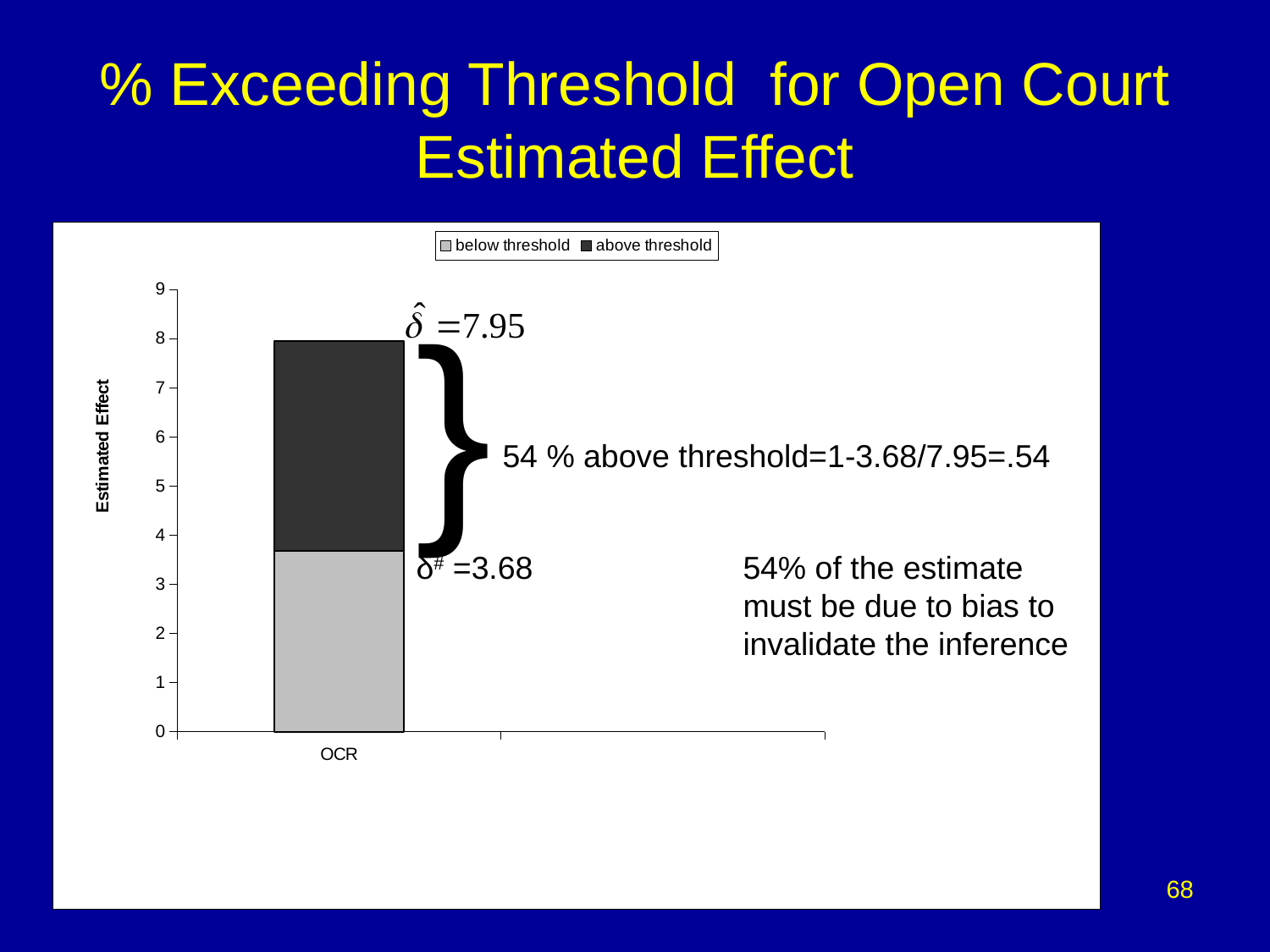
What is the label of the single category on the x axis? OCR What is the difference between the total bar height (7.95) and the below-threshold value (3.68), i.e. the size of the 'above threshold' portion? 4.27 What percentage of the OCR estimate is above the threshold, according to the annotation on the chart? 54% Which portion of the OCR bar is larger, 'above threshold' or 'below threshold'? above threshold What is the total height of the stacked OCR bar? 7.95 What kind of chart is shown on the slide? Stacked bar chart What is the value of the 'below threshold' portion of the OCR bar? 3.68 What is the title of the chart's y axis? Estimated Effect How many categories are plotted on the x axis of the chart? 1 How many series does the chart's legend list? 2 What are the two series named in the chart's legend? below threshold, above threshold Is the total height of the OCR bar greater or less than 7? greater